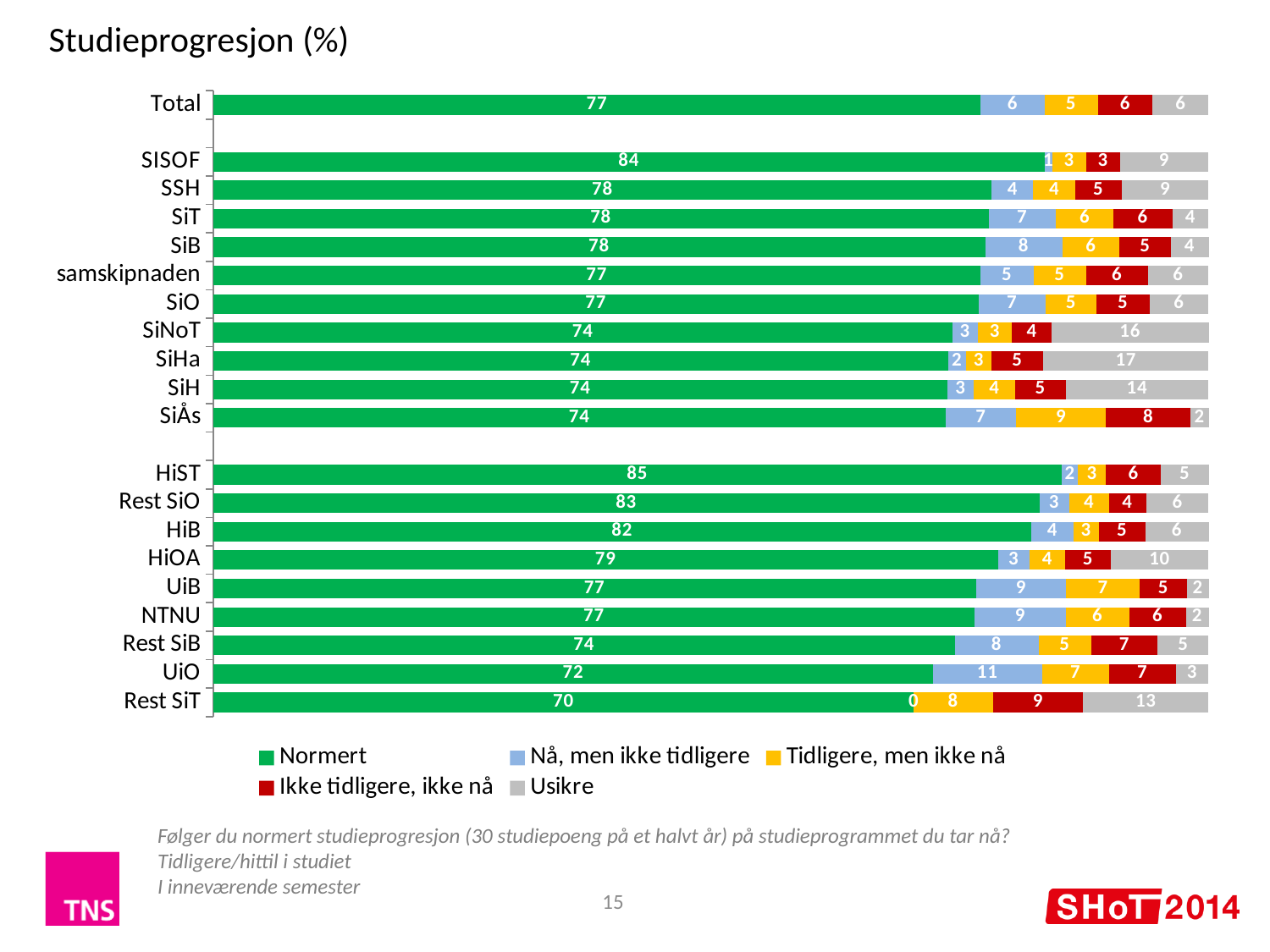
What kind of chart is shown on the slide? stacked bar chart What is the title of the chart? Studieprogresjon (%) Which has a larger 'Ikke tidligere, ikke nå' value, SiÅs or SiNoT? SiÅs How many series does the legend list? 5 Which category has the highest Normert value? HiST Which category has the lowest Normert value? Rest SiT What is the Normert value for HiST? 85 What is the difference between the Normert value for HiST and the Normert value for Rest SiT? 15 What is the 'Nå, men ikke tidligere' value for UiO? 11 How many categories (bars) are plotted in the chart? 20 What is the Usikre value for SiHa? 17 What is the total of the stacked bar for Total? 100